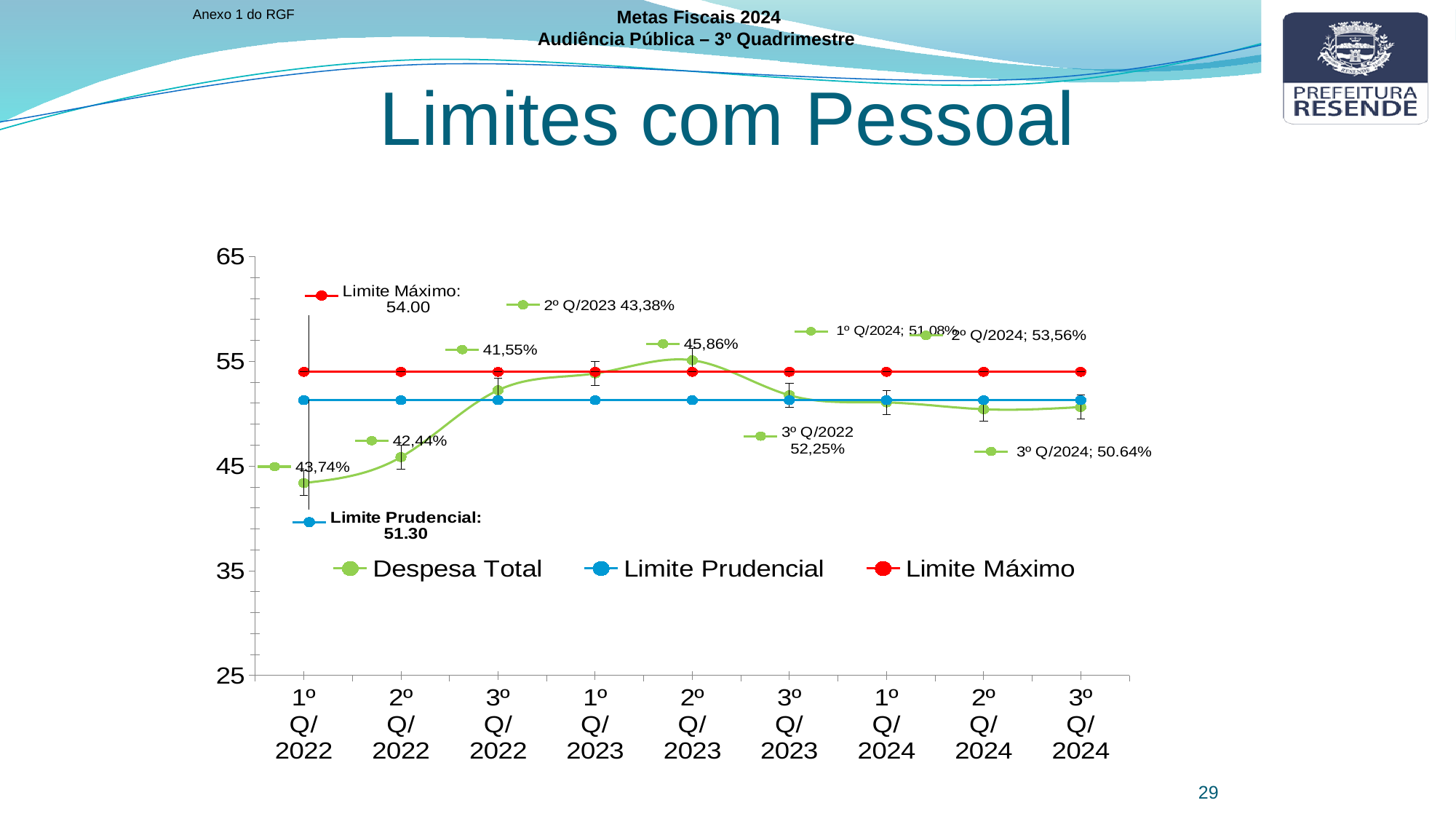
What is the value of the Limite Máximo line? 54.00 What is the Despesa Total value labelled for 3º Q/2024? 50.64% What is the Despesa Total value labelled for 1º Q/2024? 51,08% What is the difference between the Limite Máximo and the Limite Prudencial? 2.70 How many quadrimestre categories are shown on the x axis? 9 In which quadrimestre is the Despesa Total line at its lowest point? 1º Q/2022 Which is larger, the Limite Máximo or the Limite Prudencial? Limite Máximo Does the Despesa Total line rise or fall from 1º Q/2022 to 2º Q/2023? rise Is the Despesa Total value for 1º Q/2022 greater or less than 45? less What is the value of the Limite Prudencial line? 51.30 How many series does the legend list? 3 What type of chart is shown on the slide? line chart